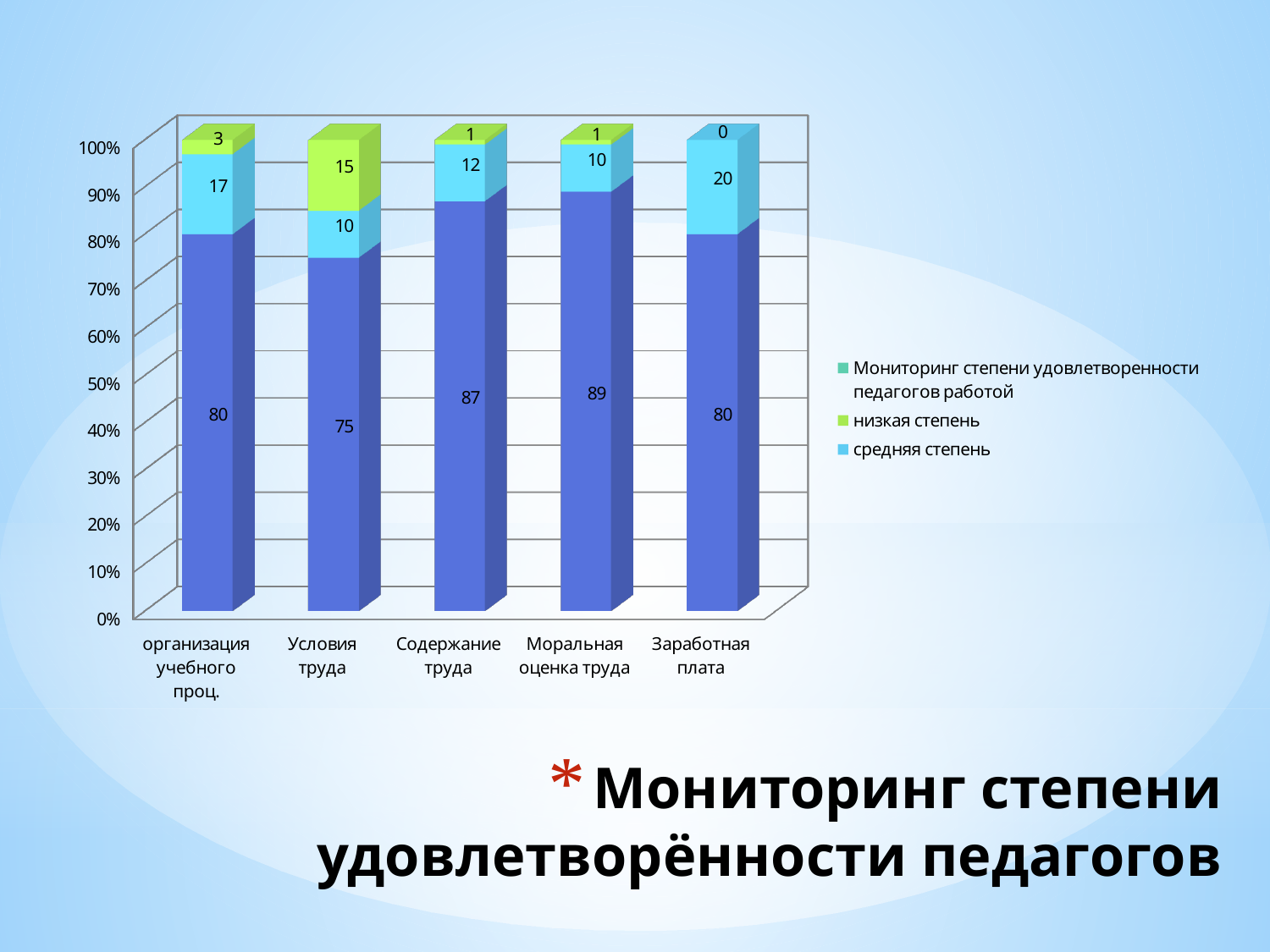
Which category has the highest низкая степень value? Условия труда How many series does the legend list? 3 What is the value of the dark blue bottom segment for Моральная оценка труда? 89 What is the value of the средняя степень segment for Заработная плата? 20 What is the difference between the средняя степень values for Заработная плата and Условия труда? 10 What is the value of the dark blue bottom segment for Содержание труда? 87 Which has the larger низкая степень value: организация учебного проц. or Содержание труда? организация учебного проц. Which category has the highest средняя степень value? Заработная плата Which category has the lowest низкая степень value? Заработная плата How many categories are shown on the x axis? 5 What kind of chart is shown on the slide? Stacked bar chart What is the value of the низкая степень segment for Условия труда? 15